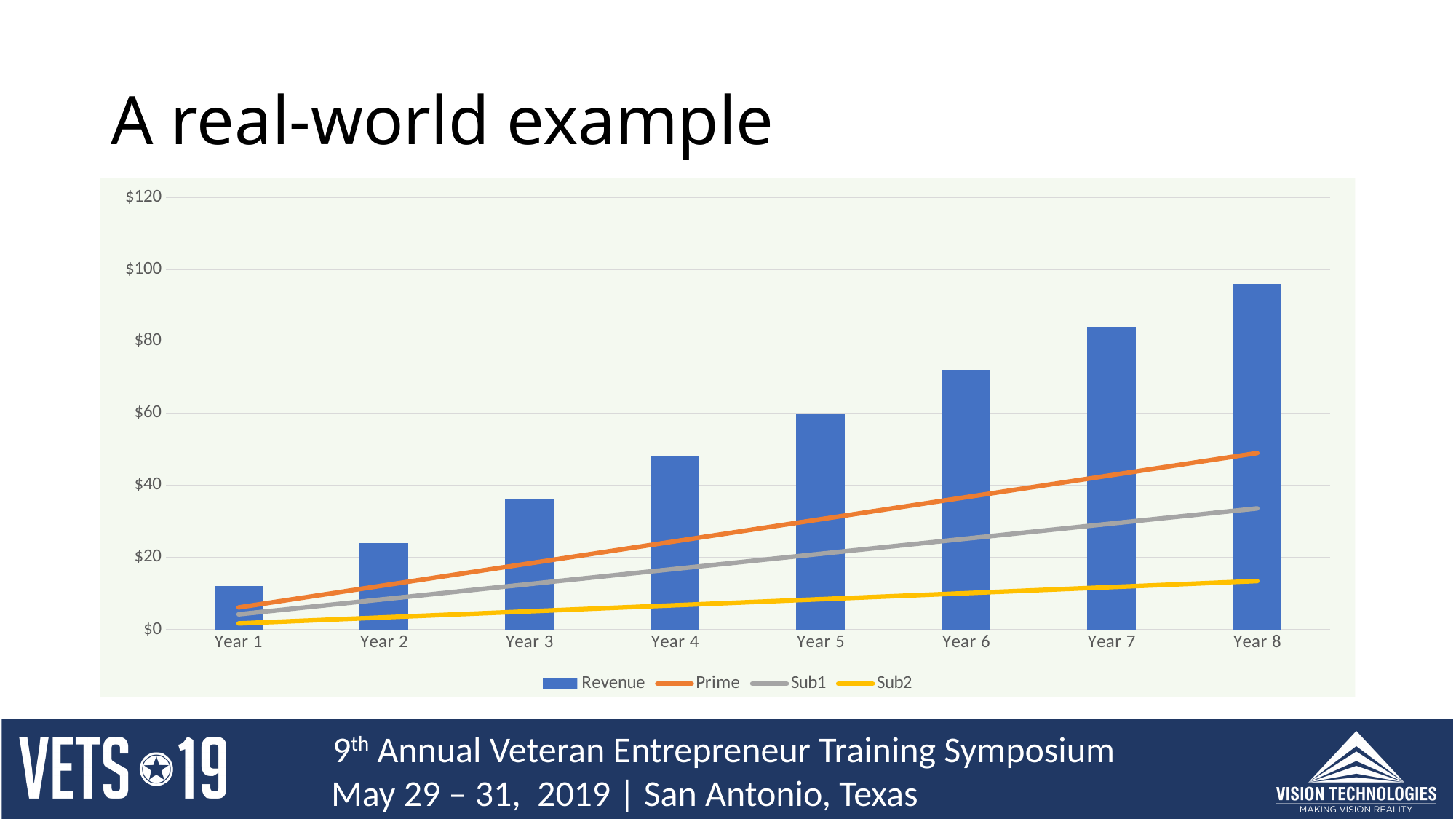
Which year has the lowest Revenue bar? Year 1 Which year has the highest Revenue bar? Year 8 What kind of chart is shown on the slide? A combined bar and line chart Is the Prime value at Year 8 greater or less than $60? less How many series does the chart's legend list? 4 Do the Revenue bars rise or fall from Year 1 to Year 8? Rise Is the Revenue value for Year 8 greater or less than $80? greater At Year 8, which line is higher: Prime or Sub1? Prime Which series in the legend is drawn as bars rather than a line? Revenue Is the Revenue value for Year 2 greater or less than $40? less How many years are shown on the x axis of the chart? 8